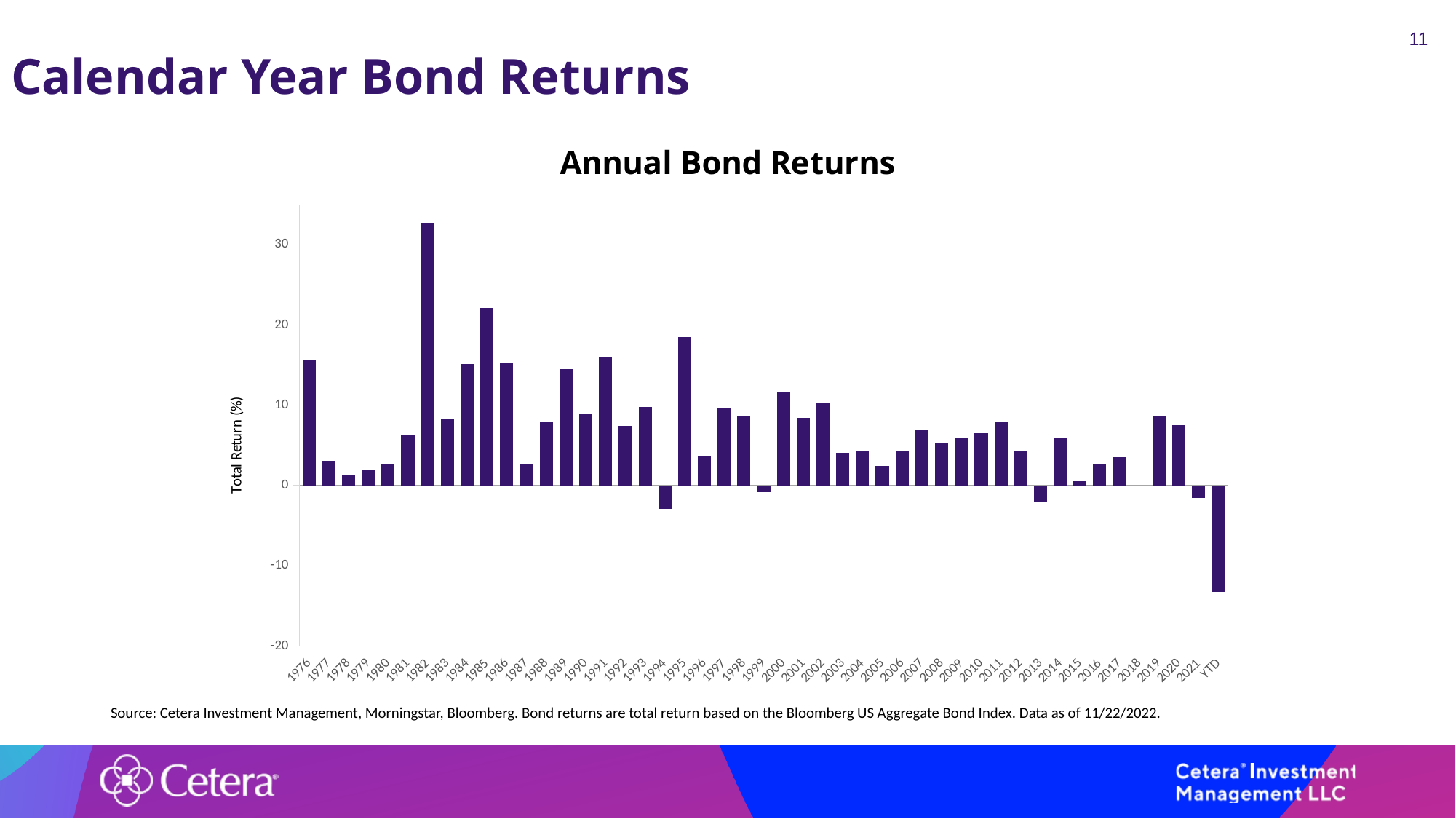
Which year has the larger annual bond return, 1982 or 1985? 1982 What is the title of the chart? Annual Bond Returns What is the label on the vertical axis of the chart? Total Return (%) Is the value for 1994 greater or less than 0? less What kind of chart is shown on the slide? Bar chart Is the value for 1976 greater or less than 10? greater Which category has the lowest annual bond return in the chart? YTD Is the value for YTD greater or less than -10? less Which year has the larger annual bond return, 1995 or 1991? 1995 Which year has the highest annual bond return in the chart? 1982